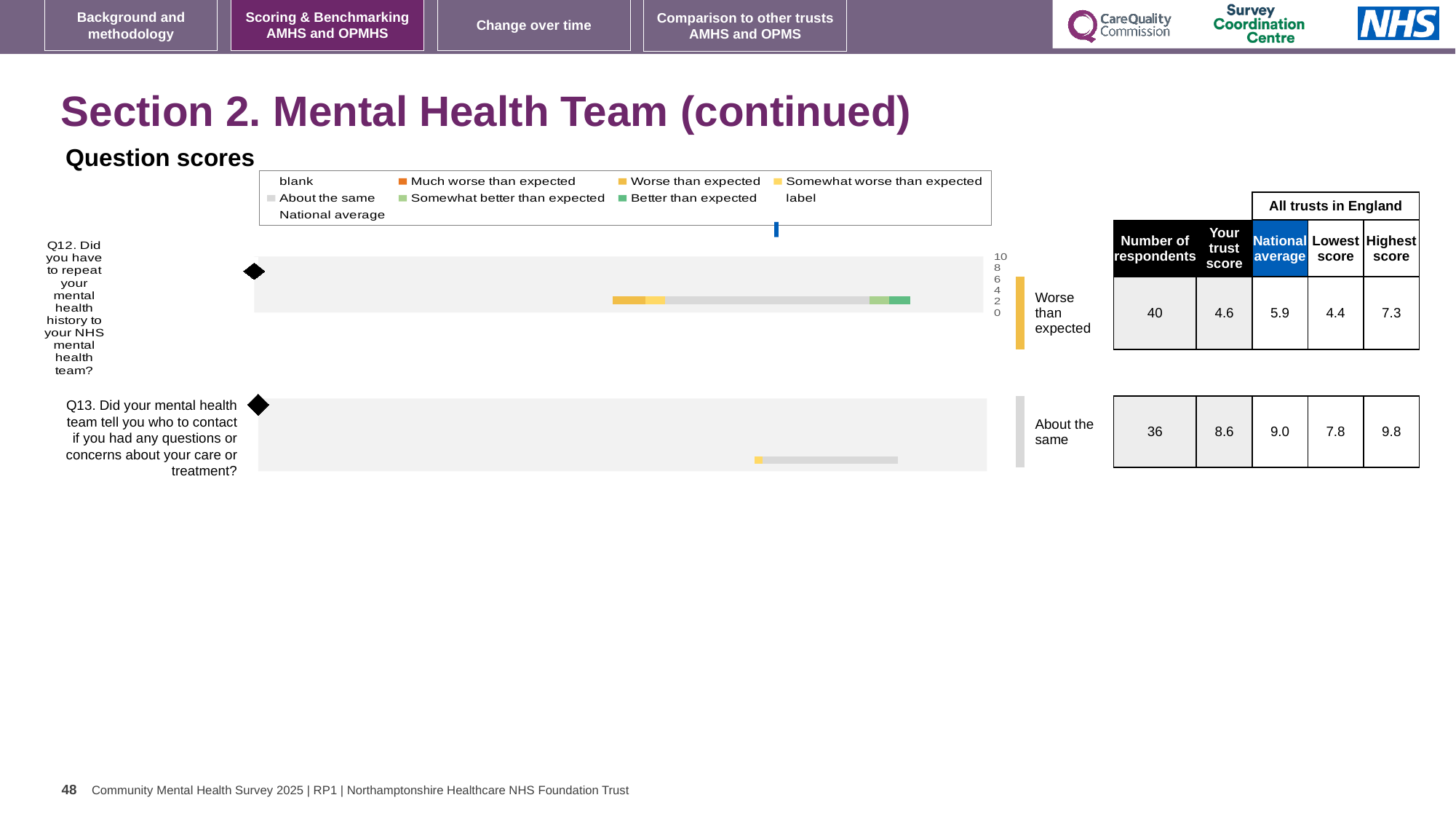
For Q12, which is larger: the trust score or the national average? national average What is the national average score for Q12? 5.9 What benchmark category is shown next to the Q12 bar? Worse than expected What is the trust score for Q13 (who to contact with questions or concerns)? 8.6 How many respondents answered Q13? 36 What is the highest score among all trusts in England for Q12? 7.3 What is the difference between the highest and lowest scores for Q13? 2.0 What kind of chart is used to show the question scores for Q12 and Q13? bar chart What is the trust score for Q12 (repeating mental health history)? 4.6 How many questions (Q12 and Q13) are plotted on the slide? 2 What is the lowest score among all trusts in England for Q13? 7.8 What benchmark category is shown next to the Q13 bar? About the same